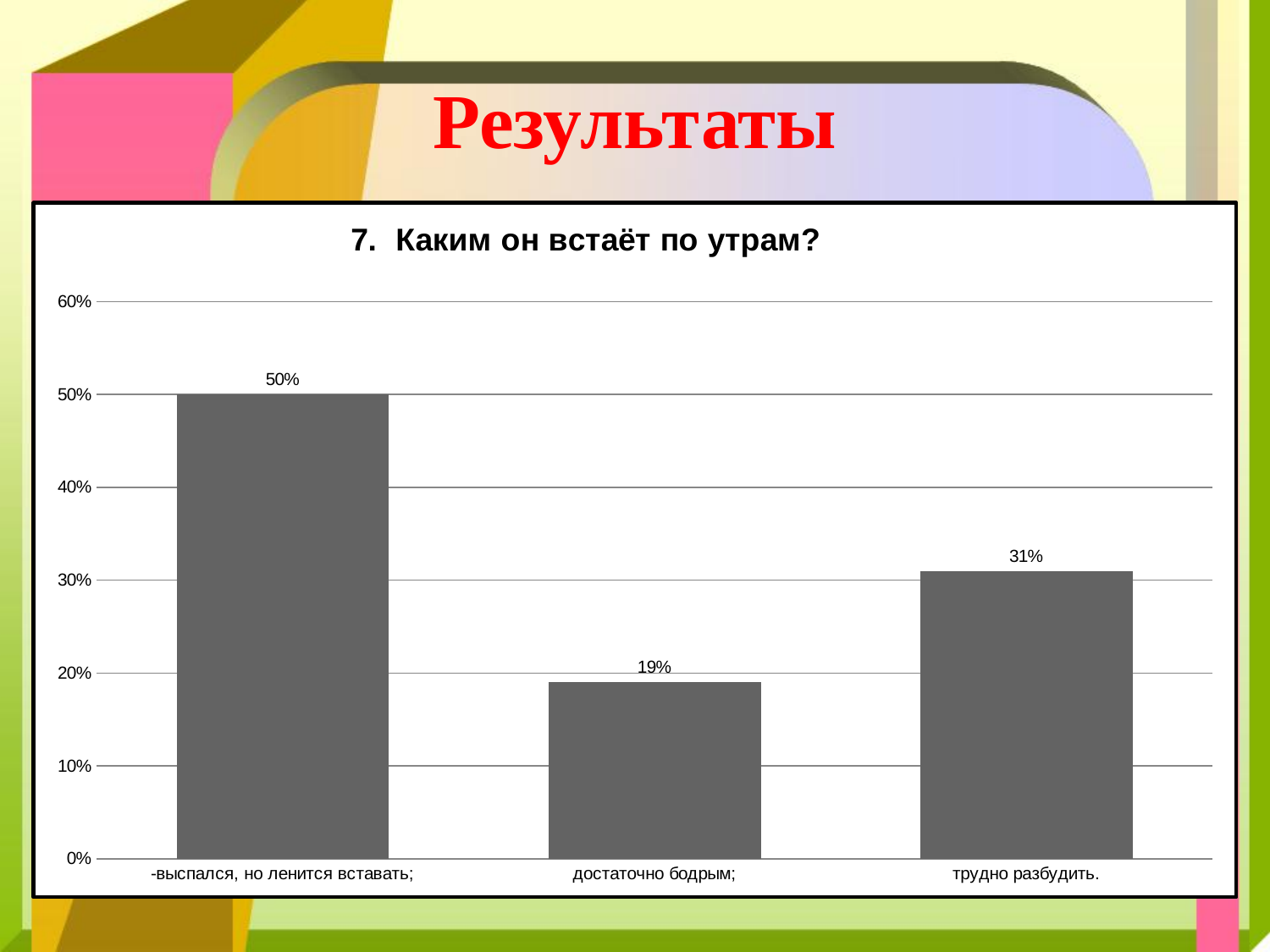
What is the title of the chart? 7. Каким он встаёт по утрам? What is the difference between the values for "-выспался, но ленится вставать;" and "трудно разбудить."? 19% Which category has the lowest value? достаточно бодрым; What is the value for "-выспался, но ленится вставать;"? 50% What is the difference between the values for "трудно разбудить." and "достаточно бодрым;"? 12% Which category has the highest value? -выспался, но ленится вставать; How many categories are shown on the x axis? 3 What is the value for "достаточно бодрым;"? 19% Is the value for "трудно разбудить." greater or less than 40%? less What is the value for "трудно разбудить."? 31% What kind of chart is shown on the slide? bar chart Which is larger, the value for "достаточно бодрым;" or the value for "трудно разбудить."? трудно разбудить.